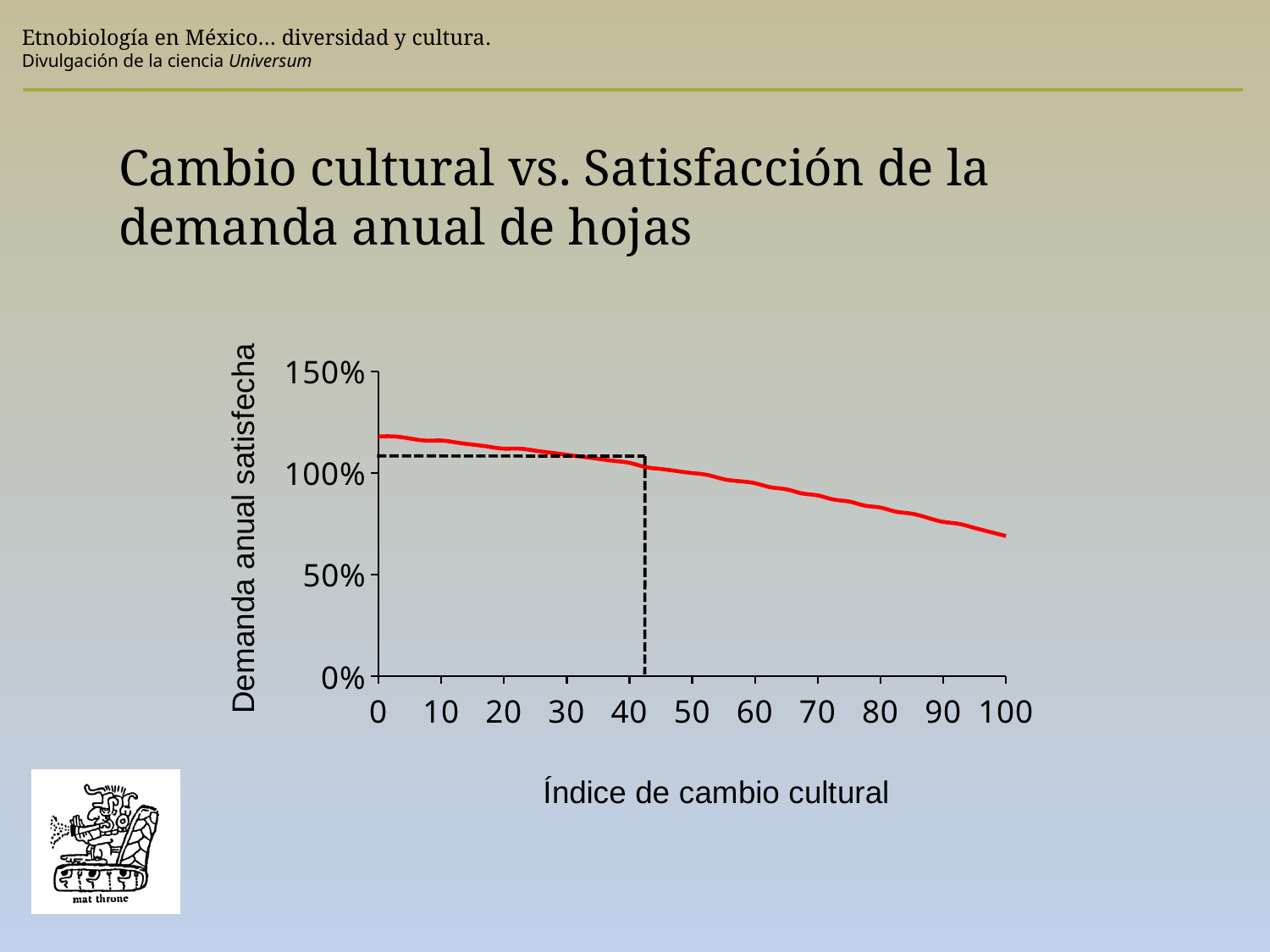
Which is larger: the Demanda anual satisfecha at an Índice de cambio cultural of 0 or at 100? at 0 Is the value of Demanda anual satisfecha at an Índice de cambio cultural of 100 greater or less than 50%? greater What is the label of the horizontal axis of the chart? Índice de cambio cultural Is the value of Demanda anual satisfecha at an Índice de cambio cultural of 0 greater or less than 100%? greater What kind of chart is shown on the slide? line chart Does the red line rise or fall as the Índice de cambio cultural increases from 0 to 100? fall At which value of the Índice de cambio cultural is the Demanda anual satisfecha highest? 0 At which value of the Índice de cambio cultural is the Demanda anual satisfecha lowest? 100 Is the value of Demanda anual satisfecha at an Índice de cambio cultural of 100 greater or less than 100%? less What is the label of the vertical axis of the chart? Demanda anual satisfecha